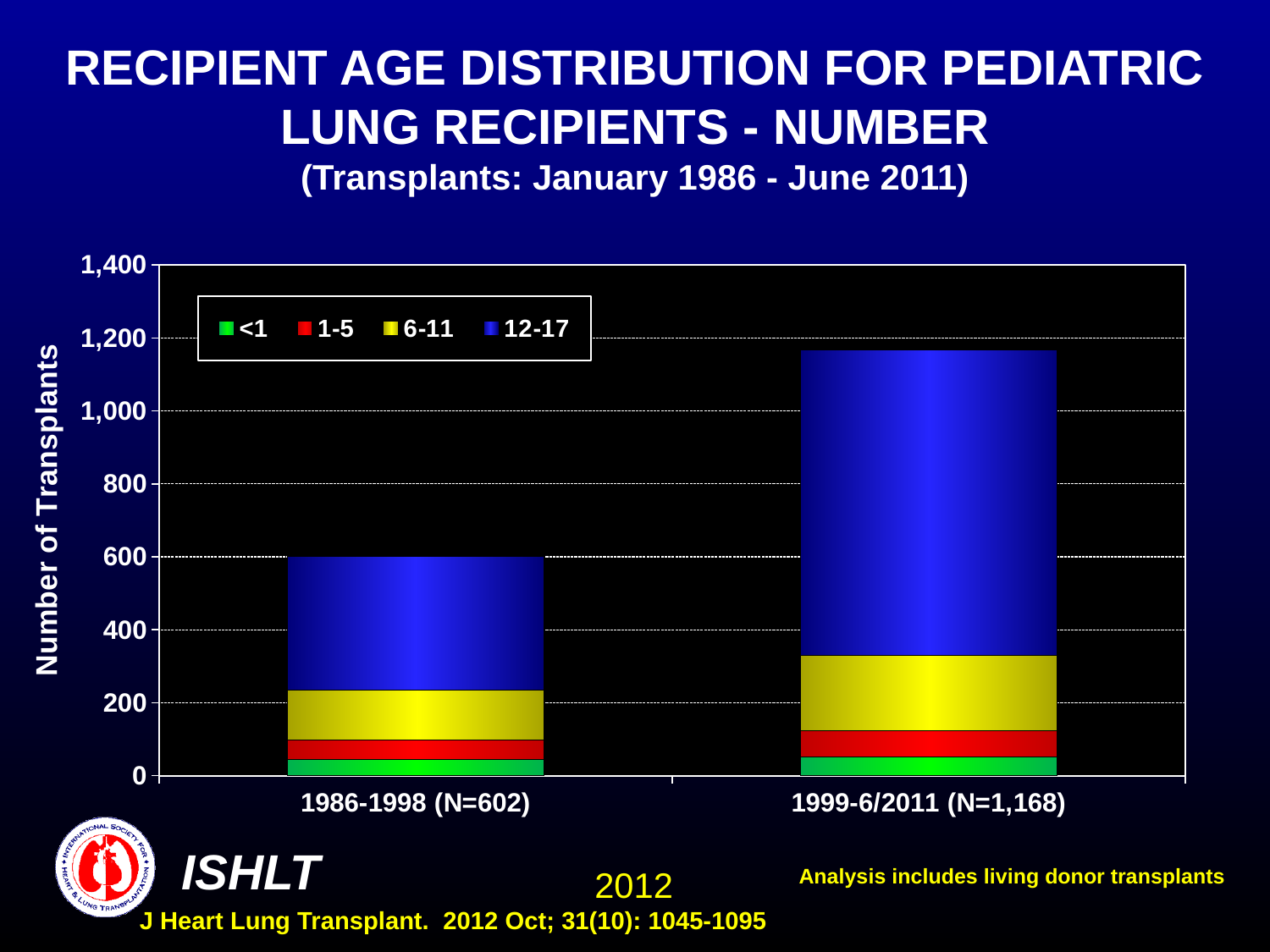
What kind of chart is shown on the slide? Stacked bar chart Which age group makes up the largest segment of the 1999-6/2011 bar? 12-17 Is the total for the 1999-6/2011 bar greater or less than 1,000? greater What is the difference in total transplants between the 1999-6/2011 period and the 1986-1998 period? 566 What is the total number of transplants for the 1999-6/2011 bar? 1,168 How many time-period categories are shown on the x axis? 2 Is the total for the 1986-1998 bar greater or less than 800? less Do the total transplant numbers rise or fall from the 1986-1998 period to the 1999-6/2011 period? Rise What is the label on the y axis? Number of Transplants Which period has the higher total number of transplants? 1999-6/2011 How many age-group series does the legend list? 4 What is the total number of transplants for the 1986-1998 bar? 602